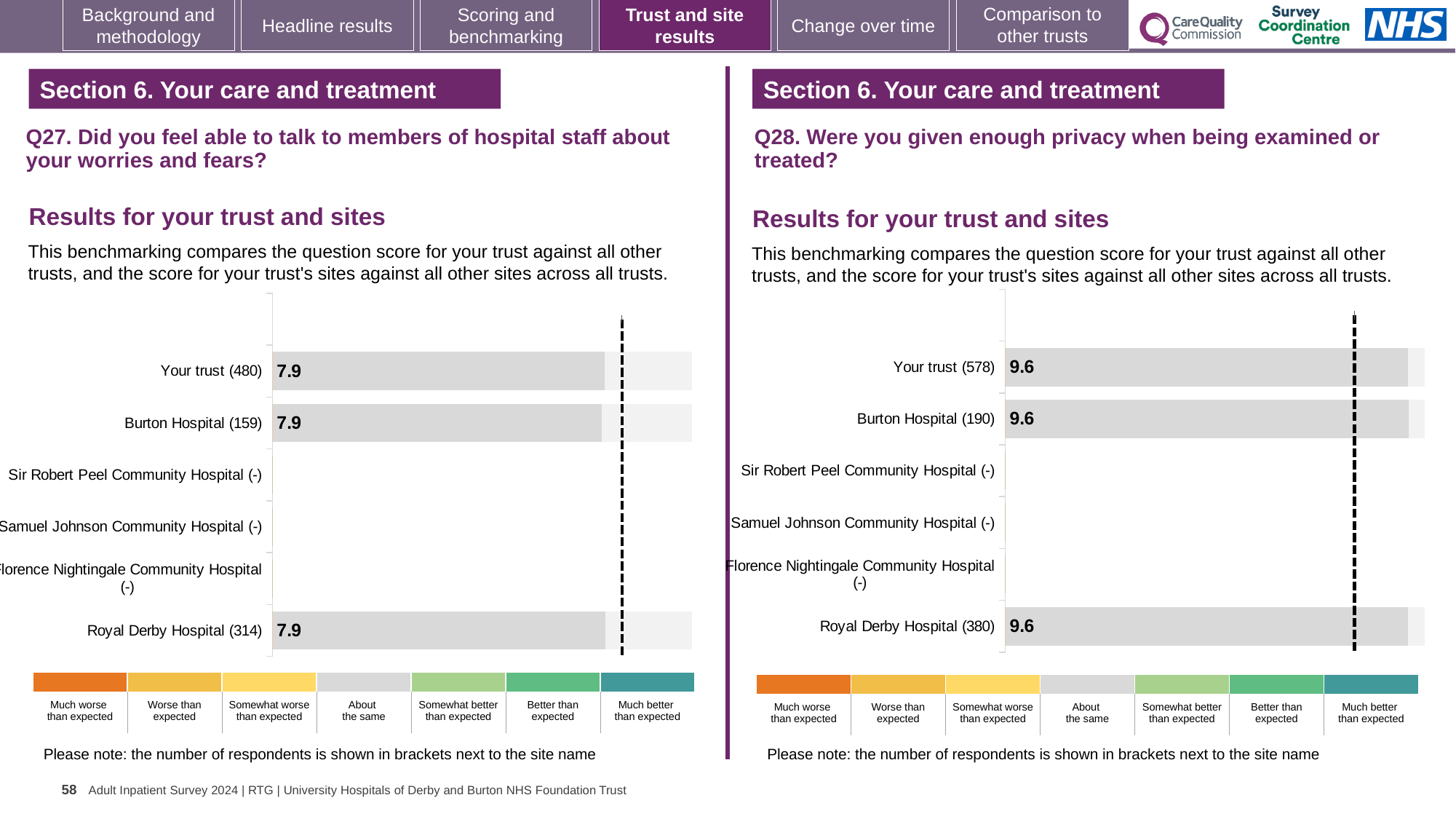
In the Q28 chart on the right, how many respondents are shown in brackets for Burton Hospital? 190 In the Q28 chart on the right, how many site categories are listed on the vertical axis? 6 In the Q27 chart on the left, what is the score for Burton Hospital (159)? 7.9 In the Q27 chart on the left, what is the score for Royal Derby Hospital (314)? 7.9 In the Q28 chart on the right, what is the score for Your trust (578)? 9.6 In the Q27 chart on the left, how many site categories are listed on the vertical axis? 6 In the Q27 chart on the left, what is the score for Your trust (480)? 7.9 In the Q28 chart on the right, what is the score for Burton Hospital (190)? 9.6 What kind of chart is the Q27 chart on the left? Bar chart In the Q28 chart on the right, what is the score for Royal Derby Hospital (380)? 9.6 In the Q27 chart on the left, what is the difference between the scores for Your trust (480) and Royal Derby Hospital (314)? 0 In the Q27 chart on the left, which category does the colour key label for the grey band represent? About the same